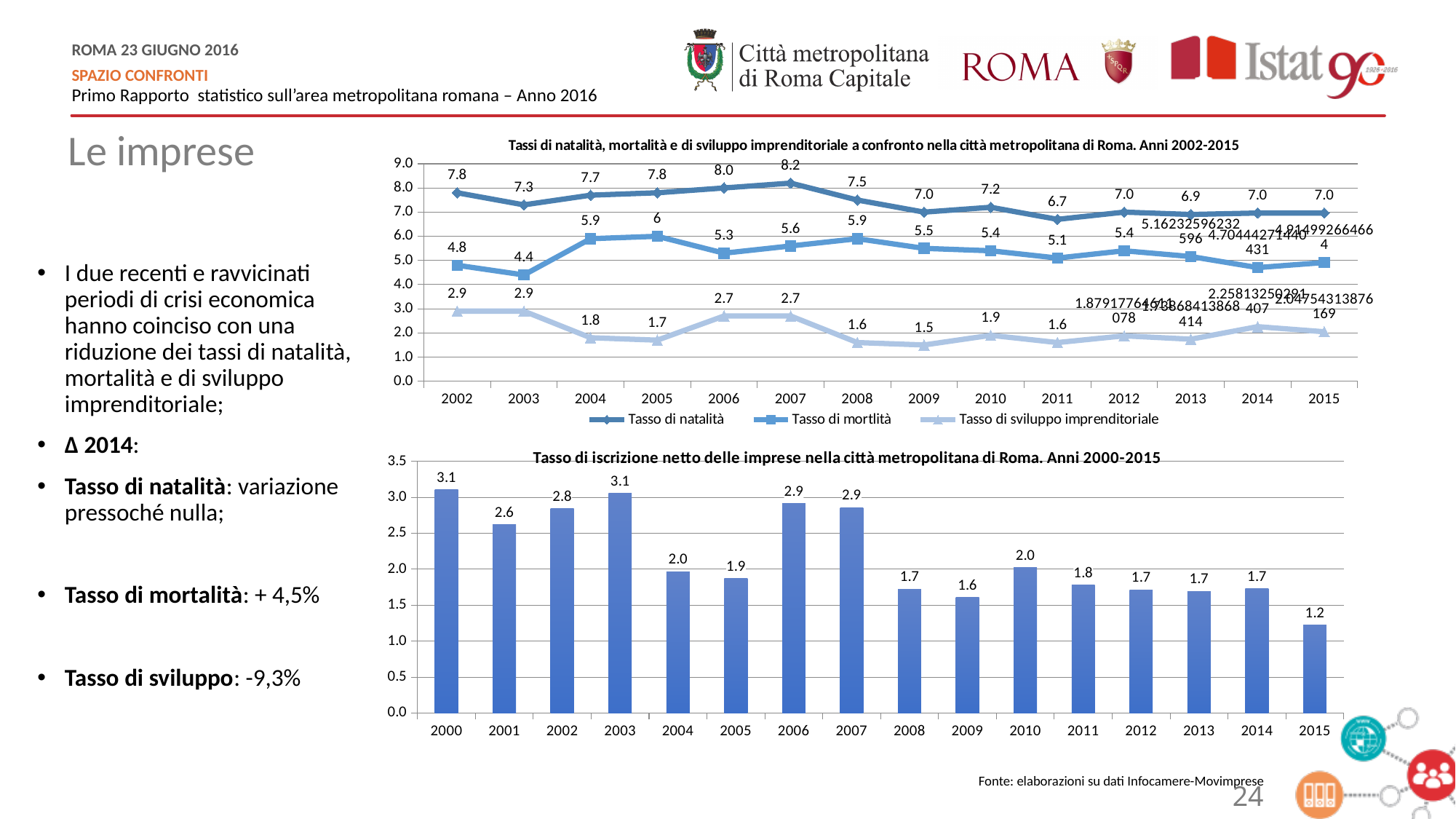
In the top chart, what is the Tasso di sviluppo imprenditoriale for 2009? 1.5 In the top chart, what is the Tasso di mortlità for 2002? 4.8 What kind of chart is the bottom chart (Tasso di iscrizione netto delle imprese)? bar chart In the top chart, in which year is the Tasso di natalità lowest? 2011 In the top chart, what is the difference between the Tasso di natalità and the Tasso di mortlità in 2003? 2.9 In the bottom chart, how many years are shown on the x axis? 16 In the bottom chart, which year has the lowest value? 2015 In the top chart (Tassi di natalità, mortalità e di sviluppo imprenditoriale), what is the Tasso di natalità for 2007? 8.2 In the top chart, how many series does the legend list? 3 In the top chart, in which year is the Tasso di natalità highest? 2007 In the bottom chart, which is larger, the value for 2006 or the value for 2009? 2006 In the bottom chart, what is the value for 2015? 1.2